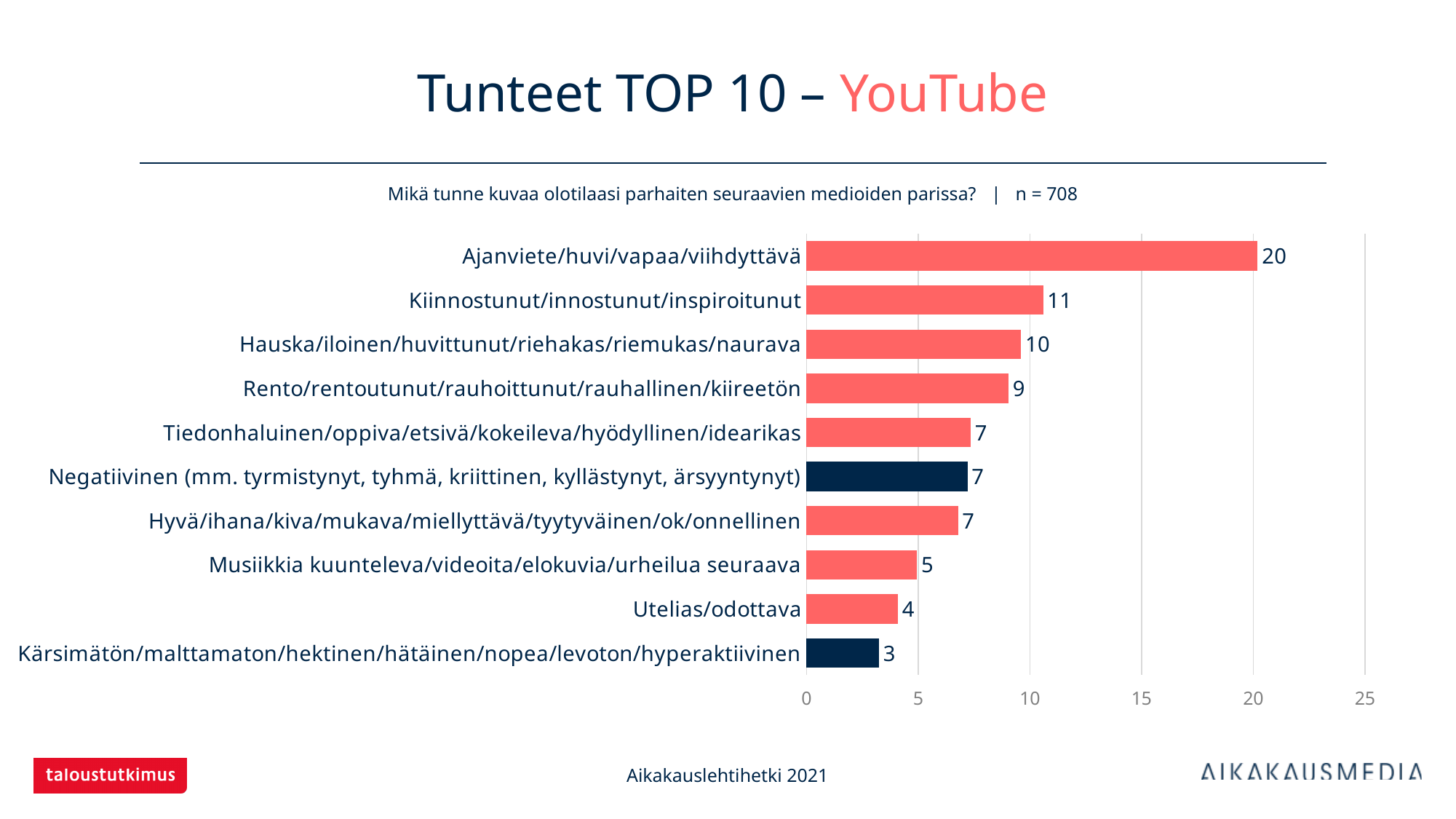
What kind of chart is shown on the slide? bar chart What is the difference between the values for Ajanviete/huvi/vapaa/viihdyttävä and Kiinnostunut/innostunut/inspiroitunut? 9 Which category has the highest value? Ajanviete/huvi/vapaa/viihdyttävä How many categories are shown in the chart? 10 What is the value for Utelias/odottava? 4 Which is larger, the value for Hauska/iloinen/huvittunut/riehakas/riemukas/naurava or the value for Musiikkia kuunteleva/videoita/elokuvia/urheilua seuraava? Hauska/iloinen/huvittunut/riehakas/riemukas/naurava Which category has the lowest value? Kärsimätön/malttamaton/hektinen/hätäinen/nopea/levoton/hyperaktiivinen What is the value for Ajanviete/huvi/vapaa/viihdyttävä? 20 What is the sample size (n) stated on the slide? n = 708 Is the value for Rento/rentoutunut/rauhoittunut/rauhallinen/kiireetön greater or less than 10? less What is the title of the slide? Tunteet TOP 10 – YouTube What is the value for Kiinnostunut/innostunut/inspiroitunut? 11